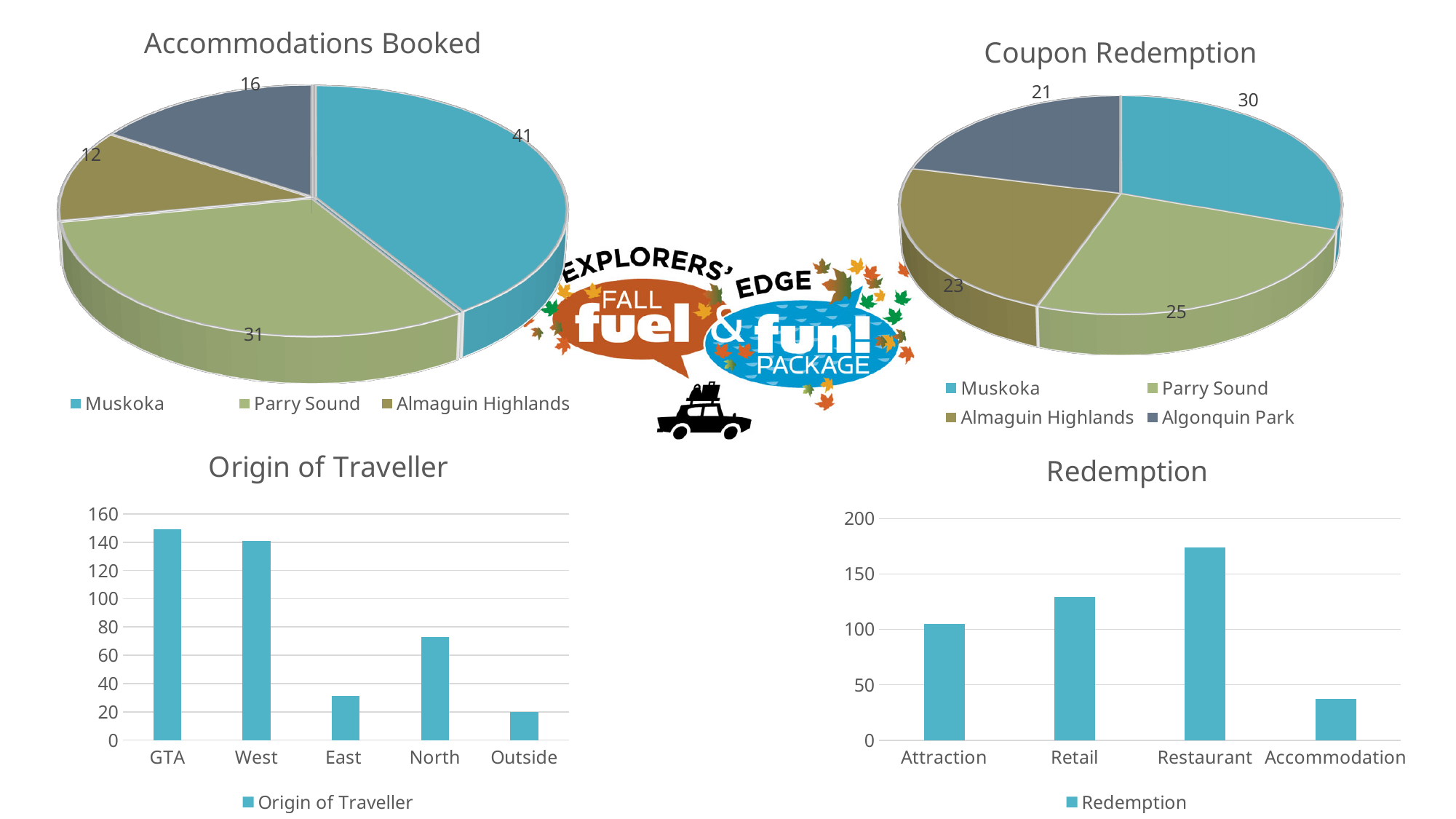
In the Coupon Redemption pie chart, what is the value for Algonquin Park? 21 In the Coupon Redemption pie chart, which region has the largest slice? Muskoka What kind of chart is the Redemption chart at the bottom right of the slide? bar chart In the Origin of Traveller chart, is the value for North greater or less than 60? greater In the Accommodations Booked pie chart, what is the value for Muskoka? 41 In the Origin of Traveller chart, which origin has the highest bar? GTA In the Origin of Traveller chart, which origin has the lowest bar? Outside In the Accommodations Booked pie chart, what is the difference between the Muskoka and Parry Sound values? 10 In the Coupon Redemption pie chart, how many regions does the legend list? 4 In the Redemption bar chart, which category has the highest value? Restaurant In the Redemption bar chart, is the value for Accommodation greater or less than 50? less In the Accommodations Booked pie chart, what is the value for Almaguin Highlands? 12